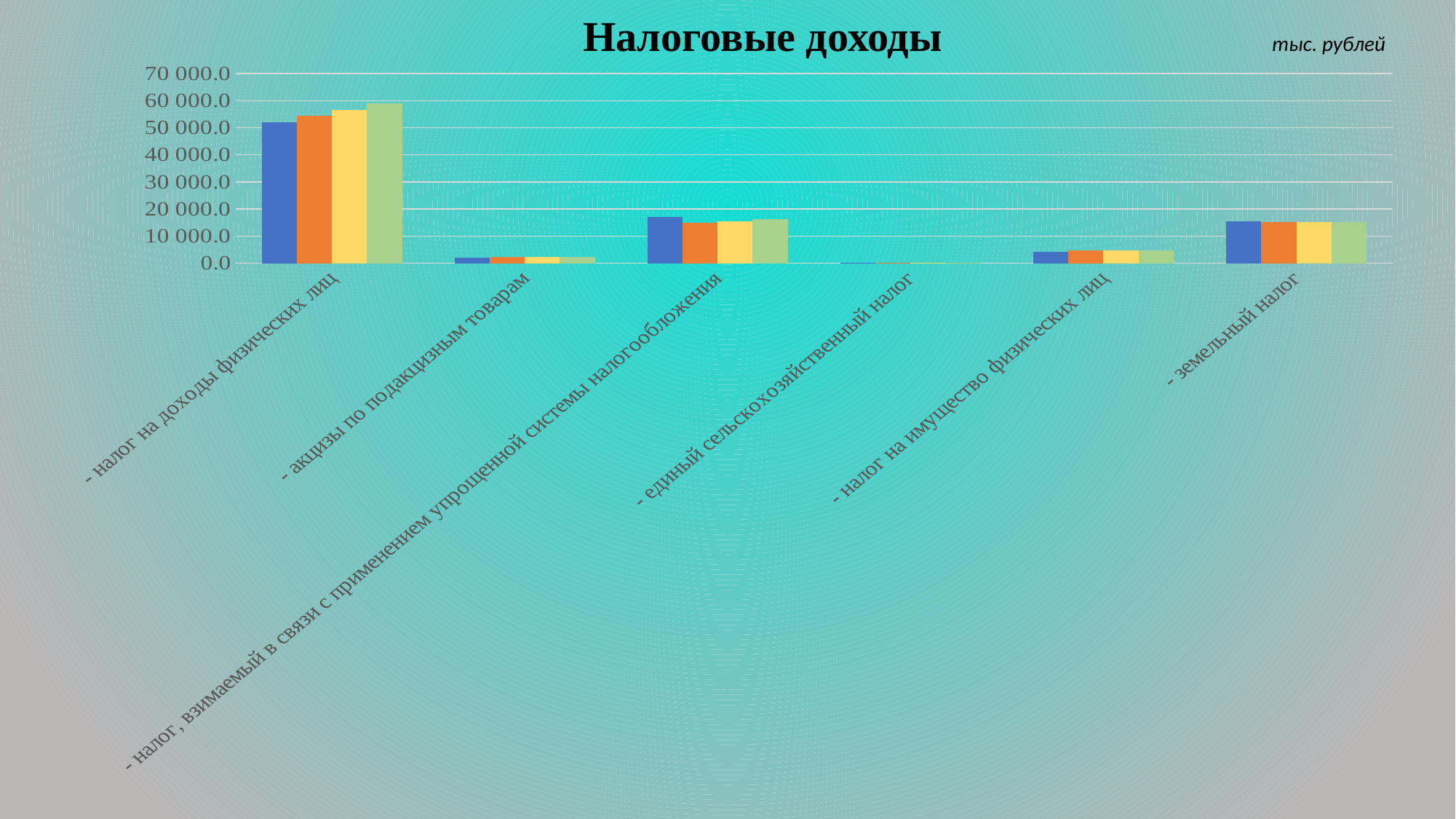
How many categories are shown on the x axis of the chart? 6 Which category has the highest values in the chart? налог на доходы физических лиц What unit is indicated for the values in the chart? тыс. рублей Do the bars for 'налог на доходы физических лиц' rise or fall from left to right within the group? rise Which category has larger values: 'земельный налог' or 'налог на имущество физических лиц'? земельный налог Which category has the lowest values in the chart? единый сельскохозяйственный налог Is the value of the first (blue) bar for 'налог, взимаемый в связи с применением упрощенной системы налогообложения' greater or less than 10 000.0? greater What is the title of the chart? Налоговые доходы What kind of chart is shown on the slide? bar chart Are the values for 'акцизы по подакцизным товарам' greater or less than 10 000.0? less Is the value of the first (blue) bar for 'налог на доходы физических лиц' greater or less than 50 000.0? greater